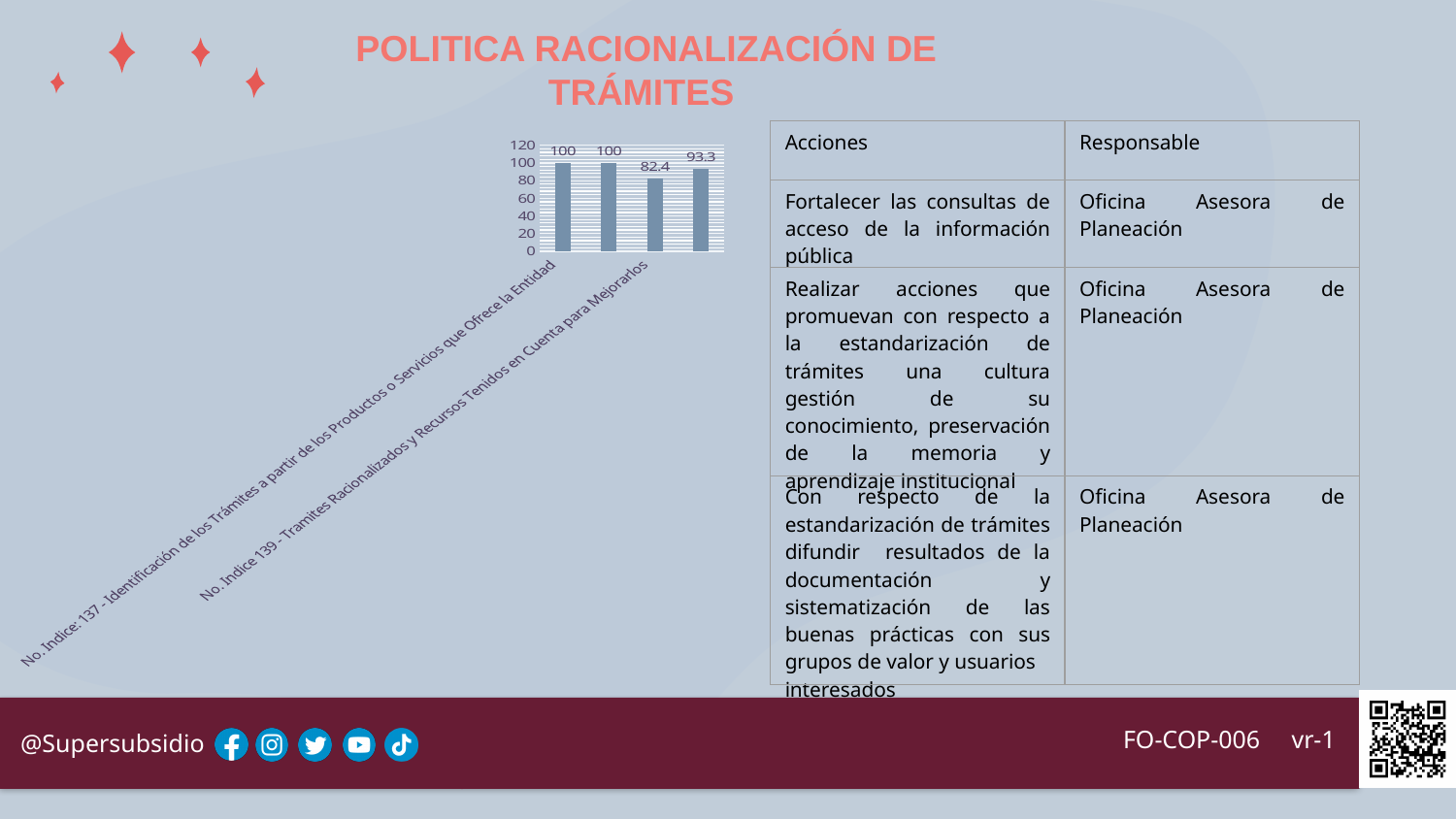
Which is larger, the value of the third bar or the value of the fourth bar? The fourth bar (93.3) What is the value of the first (leftmost) bar in the chart? 100 How many bars are plotted in the chart? 4 What is the difference between the fourth bar (93.3) and the third bar (82.4)? 10.9 What is the highest value shown by any bar in the chart? 100 What is the difference between the first bar (100) and the third bar (82.4)? 17.6 Which bar has the lowest value in the chart? The third bar (82.4) What is the value of the fourth (rightmost) bar in the chart? 93.3 Is the value of the third bar greater or less than 80? greater What type of chart is shown on the slide? Bar chart What is the maximum value shown on the chart's vertical axis? 120 What is the value of the third bar in the chart? 82.4